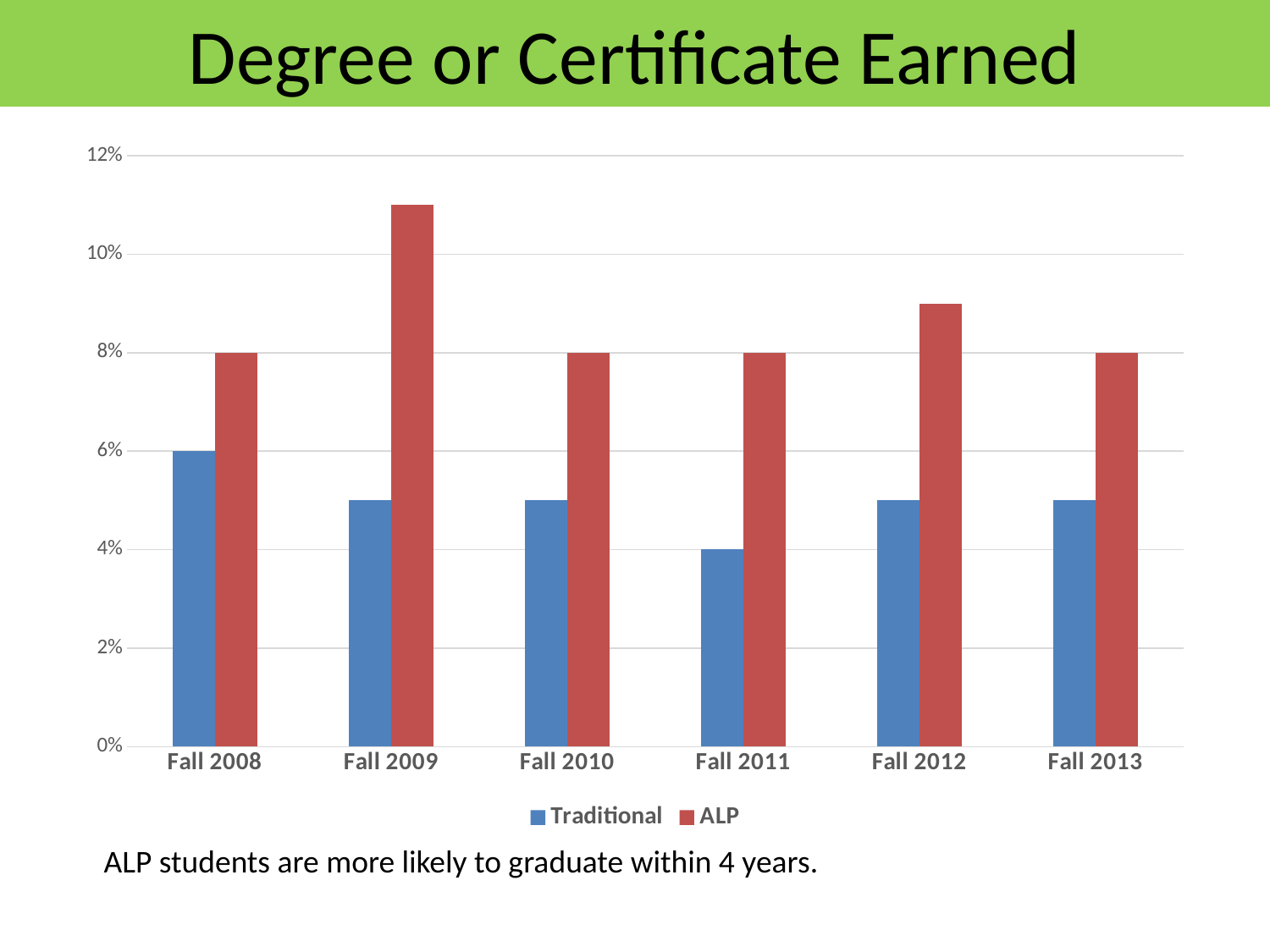
How many categories are shown on the x axis? 6 Is the ALP value for Fall 2009 greater or less than 10%? greater What is the title of the chart? Degree or Certificate Earned What is the difference between the ALP and Traditional values for Fall 2008? 2% Which is larger for Fall 2012, the Traditional value or the ALP value? ALP What is the Traditional value for Fall 2008? 6% What is the ALP value for Fall 2011? 8% What is the Traditional value for Fall 2011? 4% How many series does the legend list? 2 Which category has the lowest Traditional value? Fall 2011 What kind of chart is shown on the slide? bar chart Which category has the highest ALP value? Fall 2009